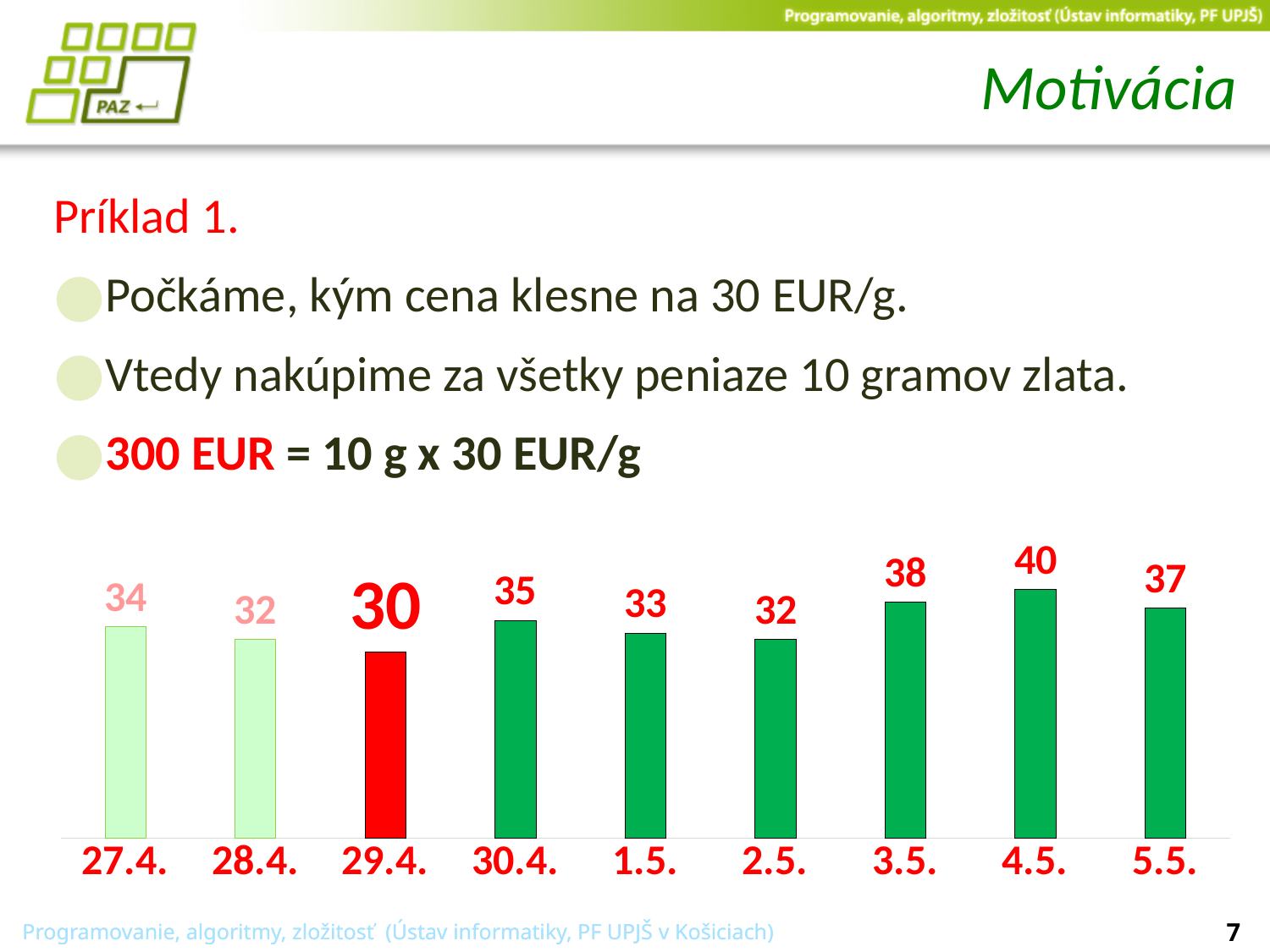
Which is larger, the value for 30.4. or the value for 5.5.? 5.5. What is the value for 29.4.? 30 What is the difference between the values for 4.5. and 29.4.? 10 What is the value for 1.5.? 33 Which date has the highest value? 4.5. Which bar is coloured red? 29.4. How many dates are shown on the x axis? 9 What is the difference between the values for 3.5. and 2.5.? 6 What is the value for 4.5.? 40 Which date has the lowest value? 29.4. What kind of chart is this? bar chart What is the value for 27.4.? 34